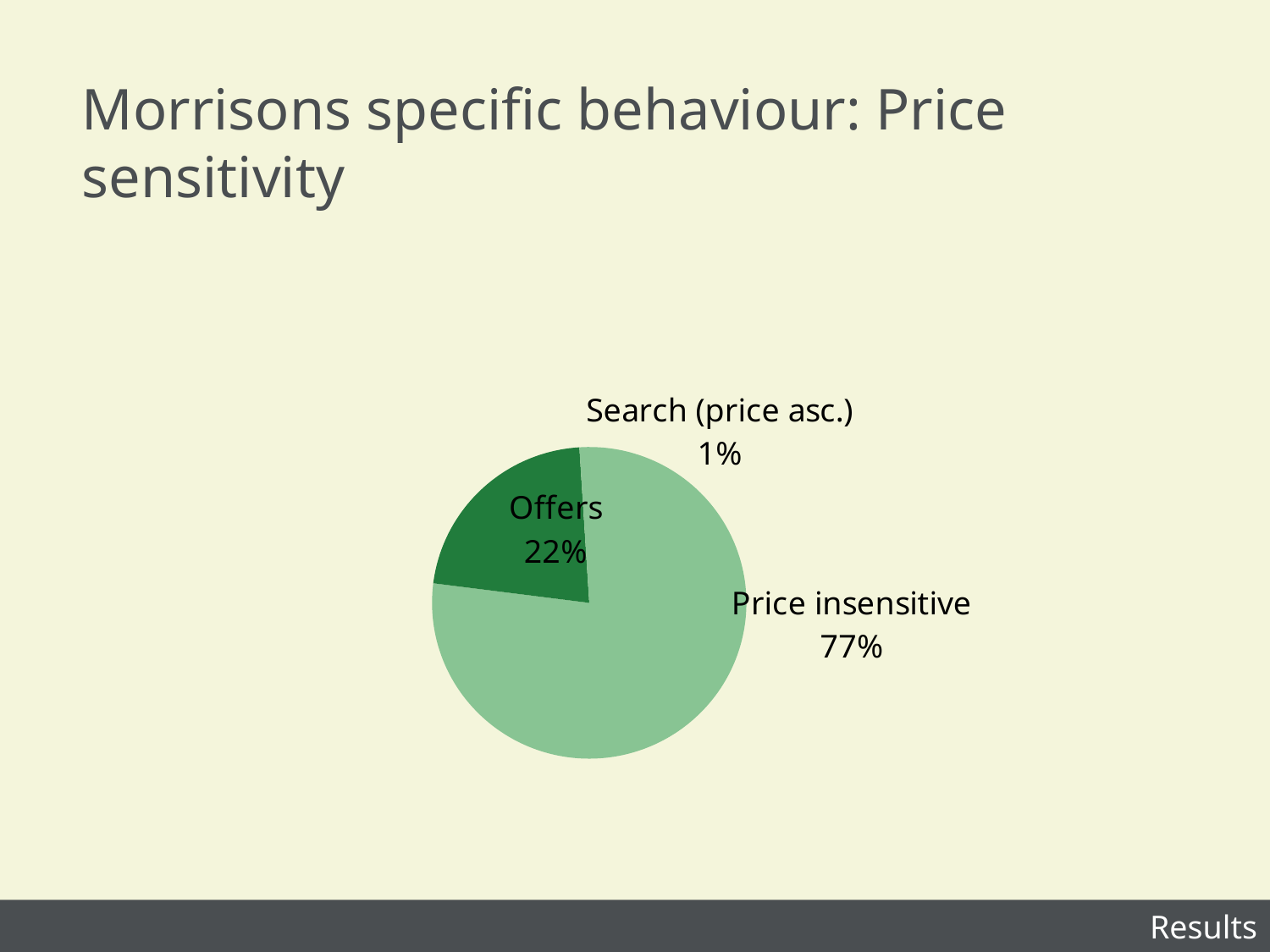
Which slice of the pie is the largest? Price insensitive Which slice of the pie is the smallest? Search (price asc.) What is the difference in percentage points between Offers and Search (price asc.)? 21 What is the title of the slide containing the pie chart? Morrisons specific behaviour: Price sensitivity Which slice of the pie is shown in the darkest green? Offers What is the difference in percentage points between Price insensitive and Offers? 55 Which is larger, Offers or Search (price asc.)? Offers What kind of chart is shown on the slide? pie chart What share of the pie does Price insensitive represent? 77% What share of the pie does Search (price asc.) represent? 1% How many slices does the pie chart have? 3 What share of the pie does Offers represent? 22%